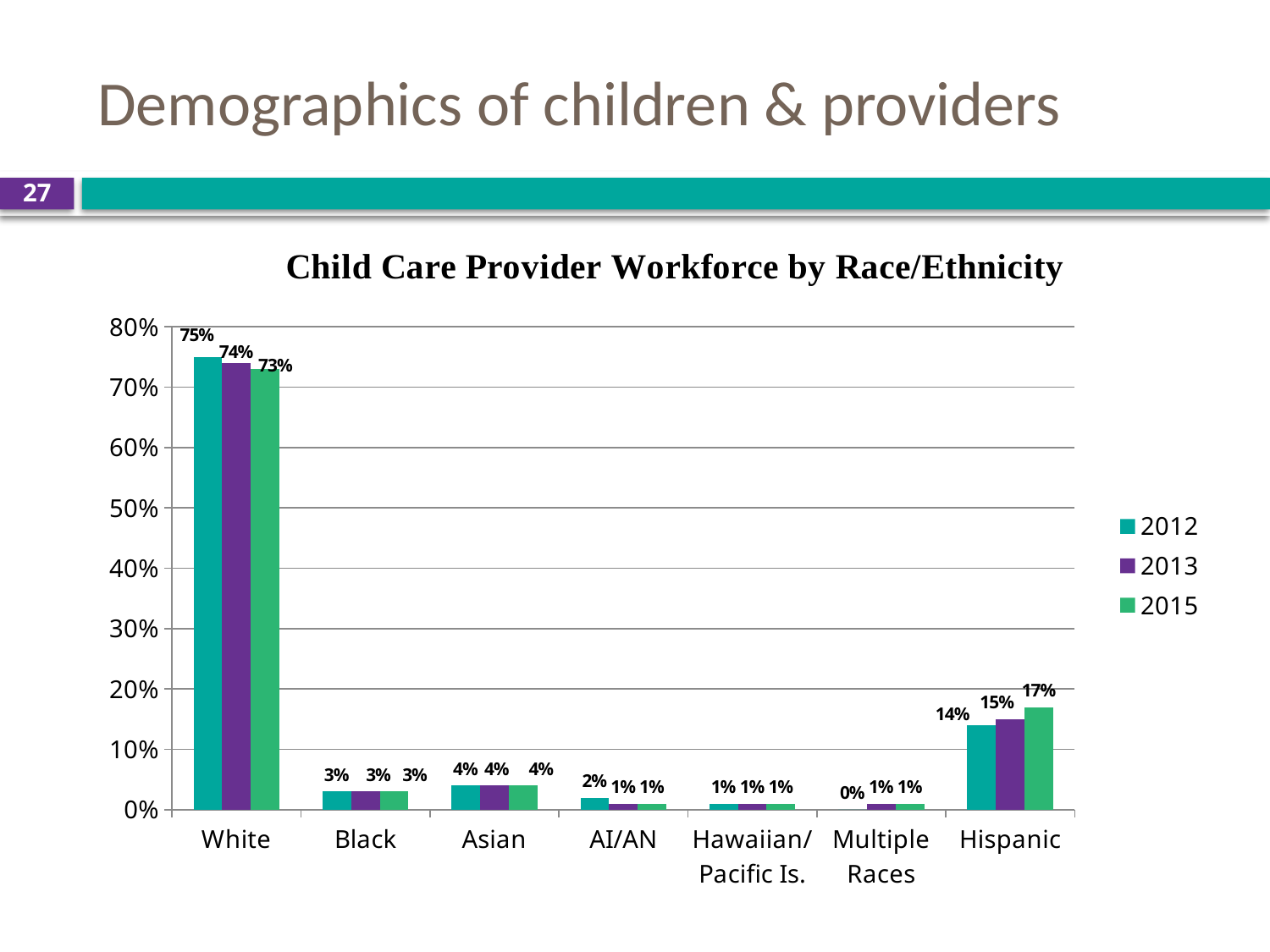
What is the value for Multiple Races in 2012? 0% What is the value for White in 2012? 75% What is the value for AI/AN in 2012? 2% Which category has the highest value in 2013? White What is the value for Hispanic in 2015? 17% Which category has the lowest value in 2012? Multiple Races How many race/ethnicity categories are shown on the x axis? 7 What is the difference between the 2012 and 2015 values for White? 2% What kind of chart is this? Bar chart How many series does the legend list? 3 Do the values for Hispanic rise or fall from 2012 to 2015? Rise Which is larger, the 2015 value for Hispanic or the 2015 value for Asian? Hispanic